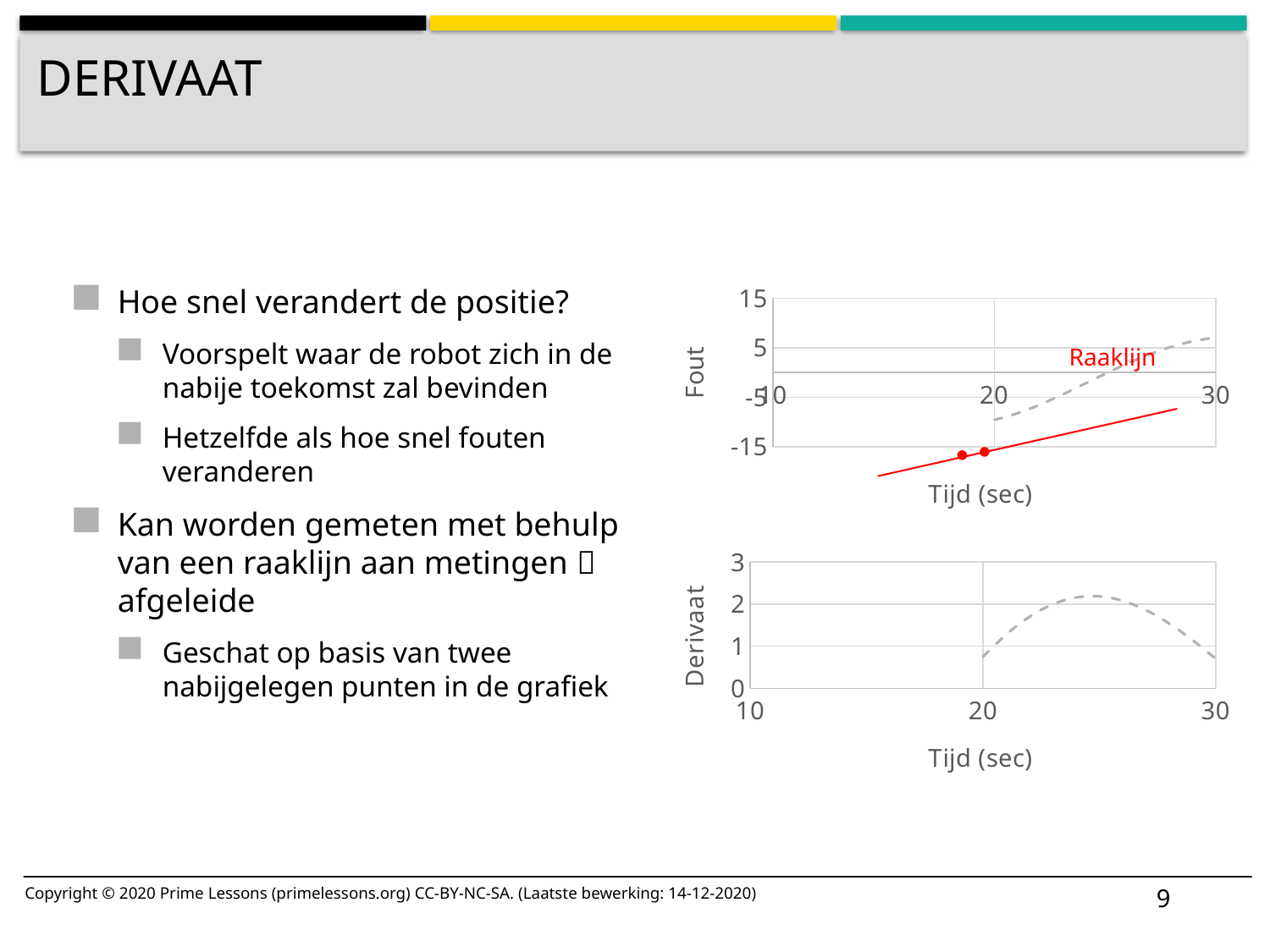
In the top chart, what is the highest value shown on the vertical axis? 15 What kind of chart is the top chart (Fout vs Tijd)? line chart In the bottom chart, is the value of the dashed curve at 20 seconds greater or less than 1? less What kind of chart is the bottom chart (Derivaat vs Tijd)? line chart In the bottom chart, what is the label on the horizontal axis? Tijd (sec) In the bottom chart, is the peak value of the dashed curve greater or less than 2? greater In the top chart, does the dashed line rise or fall as time goes from 20 to 30 seconds? rise In the top chart, is the value of the dashed line at 20 seconds greater or less than -5? less In the top chart, what is the label on the vertical axis? Fout In the bottom chart, does the dashed curve rise or fall between 25 and 30 seconds? fall